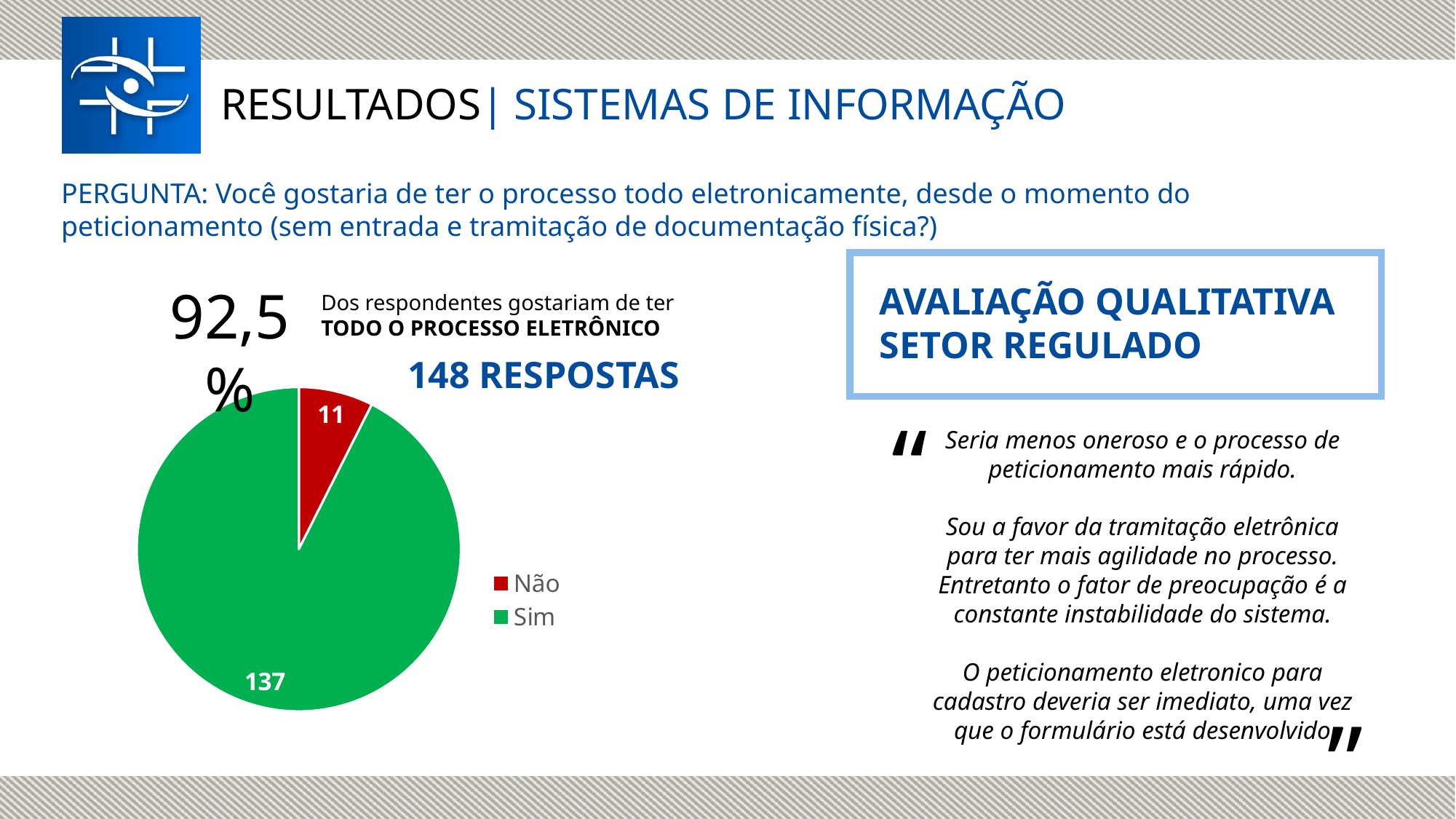
Which is larger in the pie chart, "Sim" or "Não"? Sim What is the total of all slices in the pie chart? 148 What is the value of the "Sim" slice in the pie chart? 137 What is the value of the "Não" slice in the pie chart? 11 How many entries does the legend of the pie chart list? 2 What share of the pie does the "Sim" slice represent, as printed on the slide? 92,5% How many slices does the pie chart have? 2 Which slice of the pie chart is the smallest? Não Which slice of the pie chart is the largest? Sim What kind of chart is shown on the slide? pie chart What colour is the "Não" slice in the pie chart? red What is the difference between the "Sim" and "Não" values in the pie chart? 126